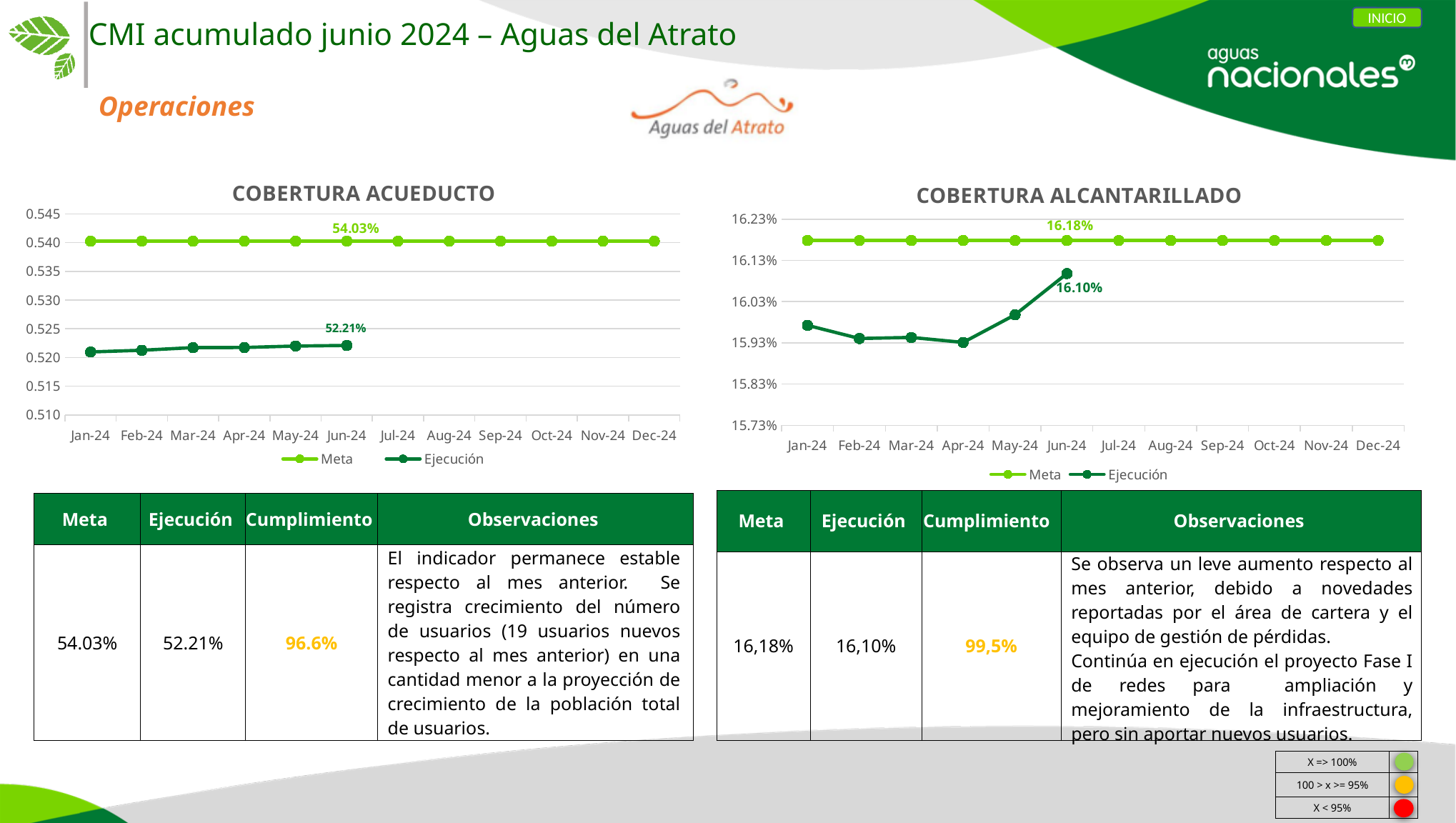
In the COBERTURA ACUEDUCTO chart, what is the difference between the labelled Meta and Ejecución values at Jun-24? 1.82% In the COBERTURA ALCANTARILLADO chart, what is the labelled Meta value at Jun-24? 16.18% How many series does the legend of the COBERTURA ACUEDUCTO chart list? 2 In the COBERTURA ALCANTARILLADO chart, which month has the highest Ejecución value? Jun-24 In the COBERTURA ALCANTARILLADO chart, does the Ejecución line rise or fall from Apr-24 to Jun-24? rise What kind of chart is the COBERTURA ACUEDUCTO chart? line chart In the COBERTURA ALCANTARILLADO chart, which is larger at Jun-24, Meta or Ejecución? Meta How many months are shown on the x axis of the COBERTURA ALCANTARILLADO chart? 12 In the COBERTURA ACUEDUCTO chart, what is the labelled Meta value at Jun-24? 54.03% In the COBERTURA ACUEDUCTO chart, what is the labelled Ejecución value at Jun-24? 52.21% In the COBERTURA ACUEDUCTO chart, is the Ejecución value for Jan-24 greater or less than 0.525? less In the COBERTURA ALCANTARILLADO chart, what is the labelled Ejecución value at Jun-24? 16.10%